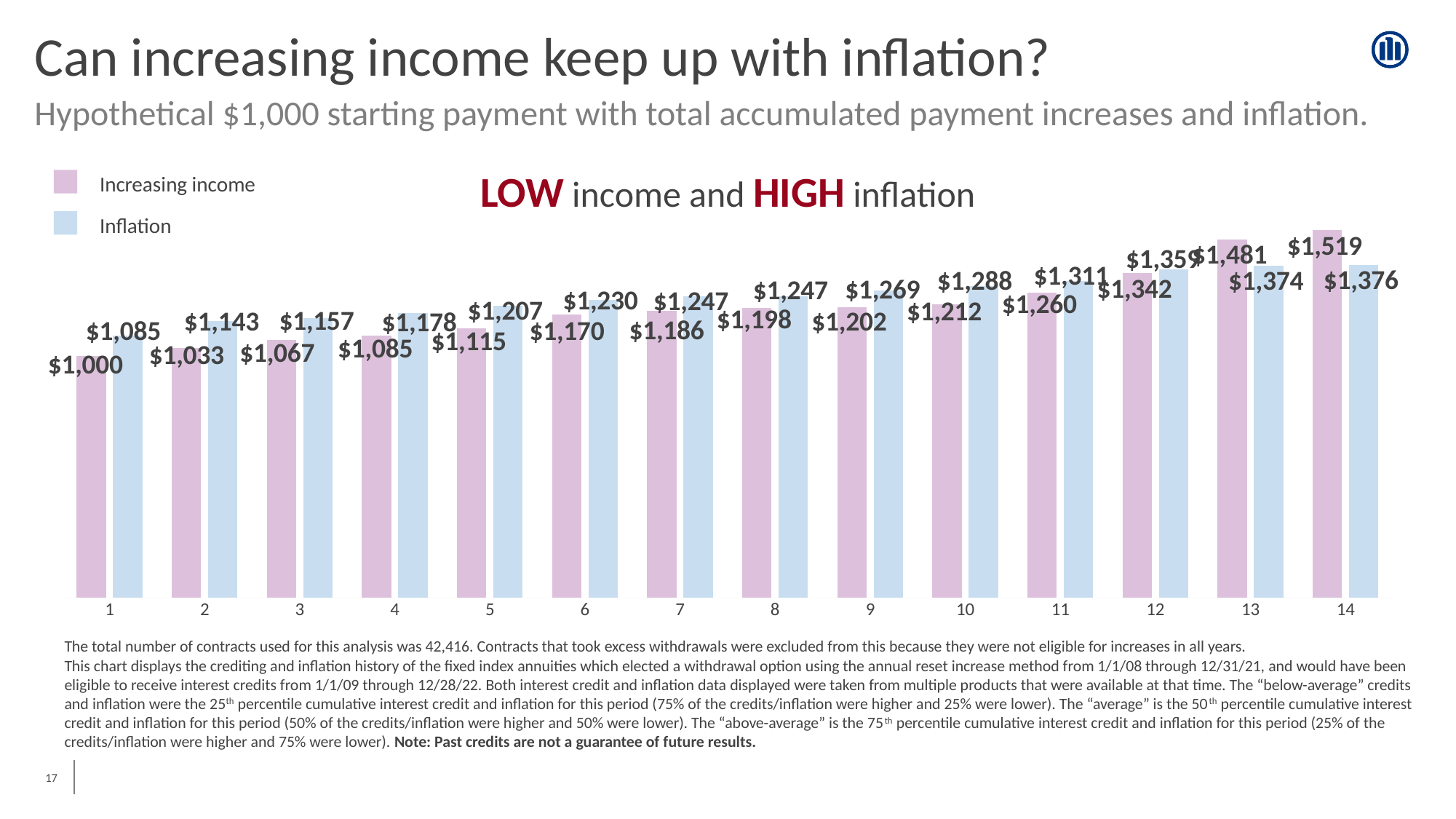
What is the Inflation value for year 10? $1,288 What is the Increasing income value for year 14? $1,519 What is the Inflation value for year 1? $1,085 What kind of chart is shown on the slide? Bar chart How many series does the legend list? 2 Which year has the lowest Inflation value? 1 In year 13, which is larger: Increasing income or Inflation? Increasing income What is the difference between the Inflation and Increasing income values in year 1? $85 What is the difference between the Increasing income values in year 14 and year 13? $38 Which year has the highest Increasing income value? 14 What is the Increasing income value for year 1? $1,000 How many years are shown on the x axis? 14